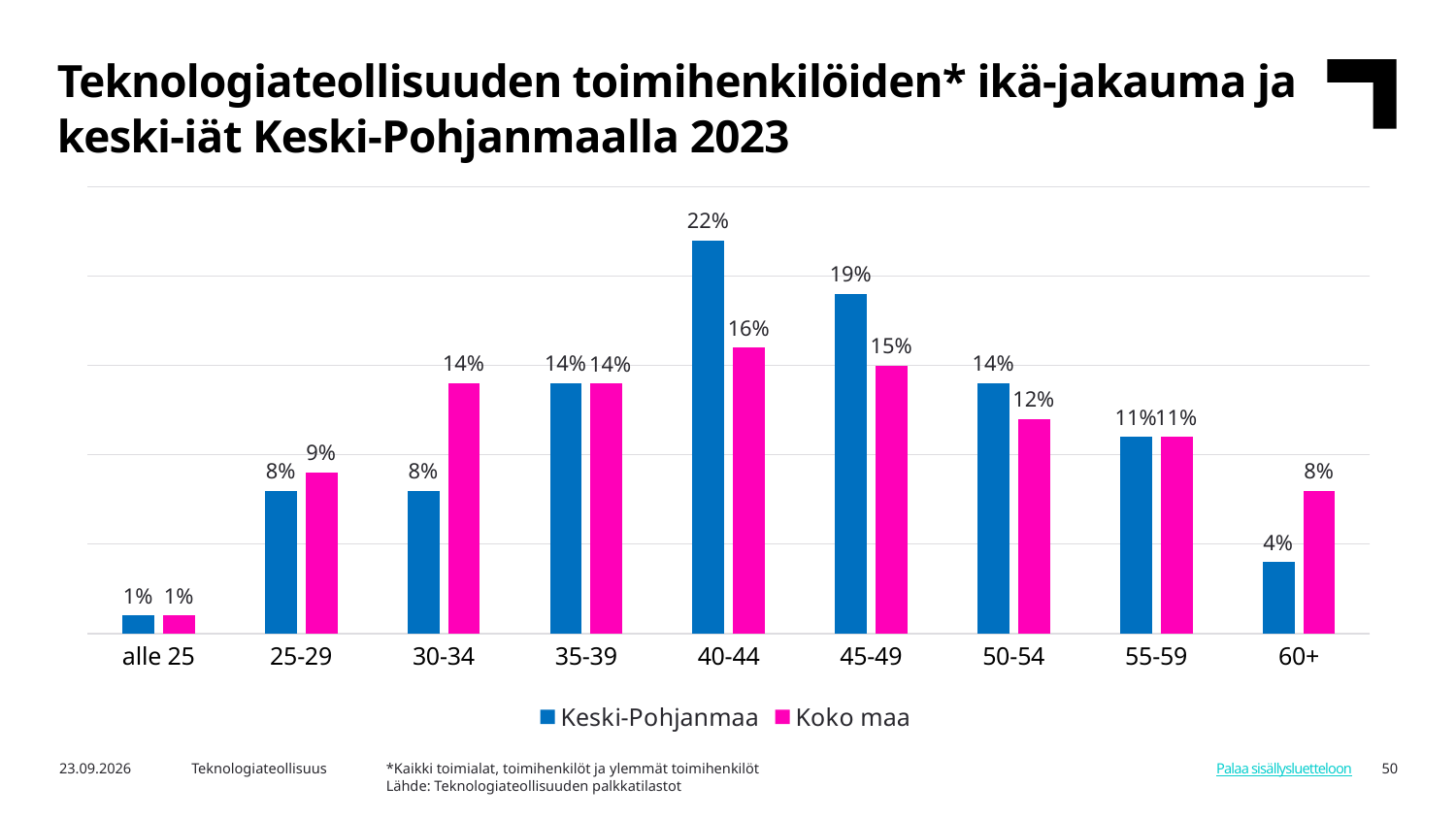
How many series does the legend list? 2 What kind of chart is shown on the slide? Bar chart What is the value for Koko maa in the 60+ age group? 8% How many age groups are shown on the x axis? 9 Which age group has the highest value for Keski-Pohjanmaa? 40-44 What is the difference between Keski-Pohjanmaa and Koko maa in the 30-34 age group? 6% What is the value for Koko maa in the 25-29 age group? 9% What is the value for Keski-Pohjanmaa in the 40-44 age group? 22% Which series is shown in pink? Koko maa Which age group has the lowest value for Koko maa? alle 25 Which is larger in the 60+ age group, Keski-Pohjanmaa or Koko maa? Koko maa What is the difference between Keski-Pohjanmaa and Koko maa in the 40-44 age group? 6%